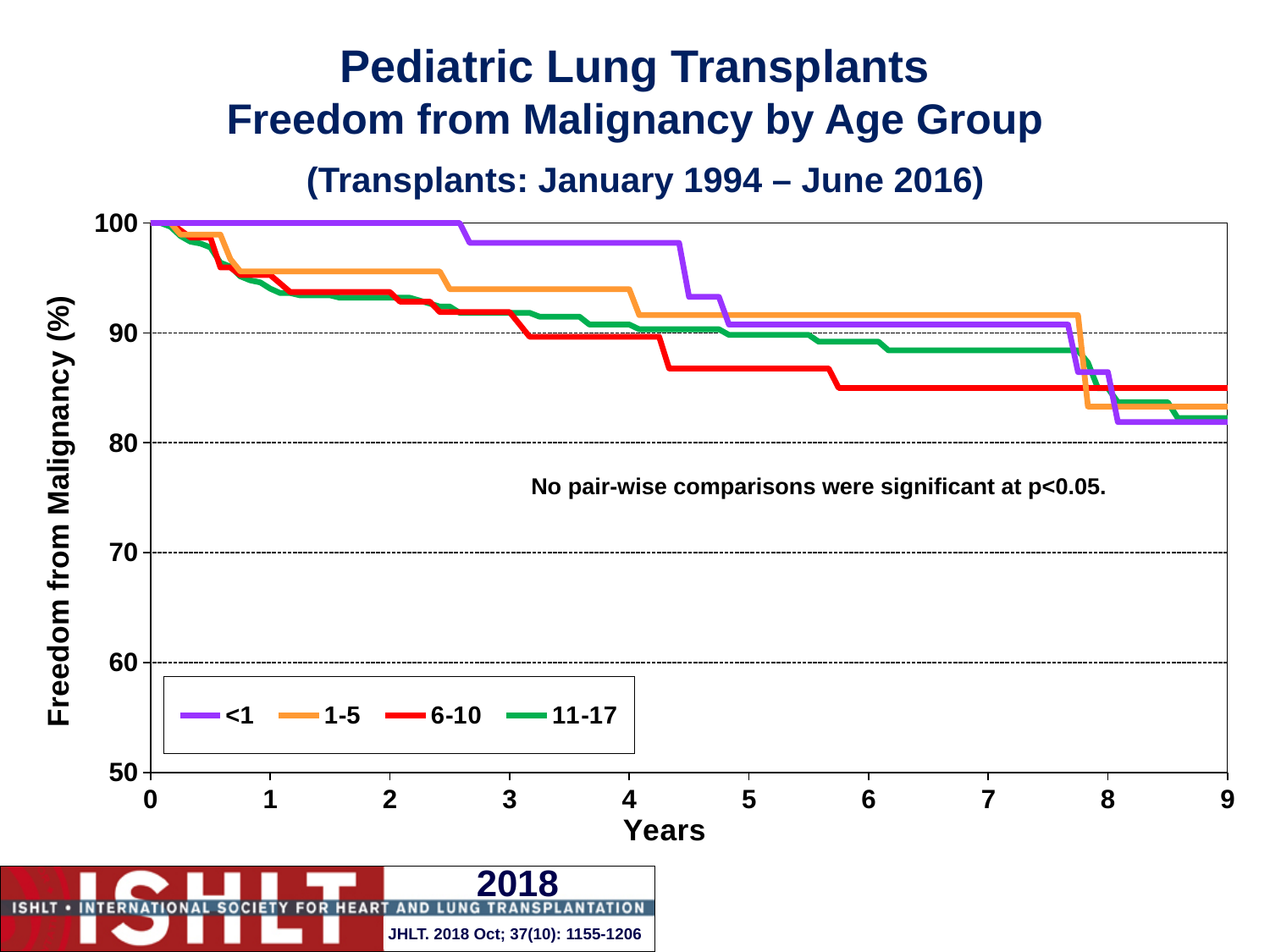
What is the label of the x axis? Years What is the freedom from malignancy value for the <1 age group at year 0? 100 What kind of chart is shown on the slide? line chart Is the value for the 6-10 age group at year 5 greater or less than 90? less Is the value for the 11-17 age group at year 9 greater or less than 90? less At year 5, which series has the lowest freedom from malignancy? 6-10 Do the values for the 6-10 age group rise or fall as years increase? fall How many series does the legend list? 4 Which age groups are listed in the legend? <1, 1-5, 6-10, 11-17 Is the value for the <1 age group at year 2 greater or less than 90? greater At year 2, which is higher: the <1 series or the 6-10 series? <1